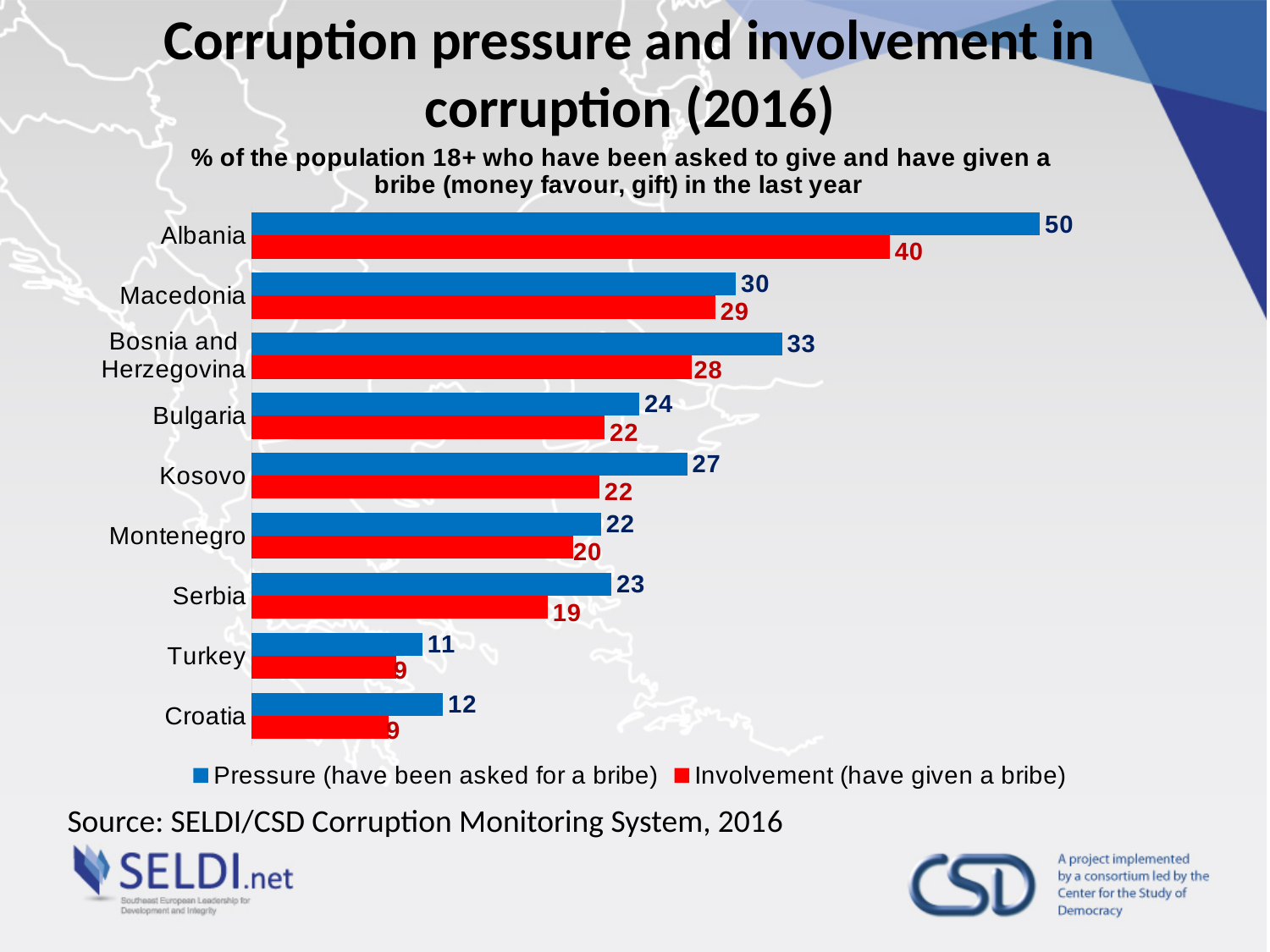
What is the difference between the Pressure values for Bosnia and Herzegovina and Macedonia? 3 Which country has the highest Pressure (have been asked for a bribe) value? Albania How many countries are shown in the chart? 9 What kind of chart is shown on the slide? Bar chart Which country has the lowest Pressure (have been asked for a bribe) value? Turkey How many series does the legend list? 2 What is the Involvement (have given a bribe) value for Bosnia and Herzegovina? 28 What is the difference between the Pressure and Involvement values for Albania? 10 What is the Involvement (have given a bribe) value for Serbia? 19 Which is larger, the Pressure value for Kosovo or the Pressure value for Bulgaria? Kosovo What is the Pressure (have been asked for a bribe) value for Albania? 50 Which colour represents the Involvement (have given a bribe) series? Red